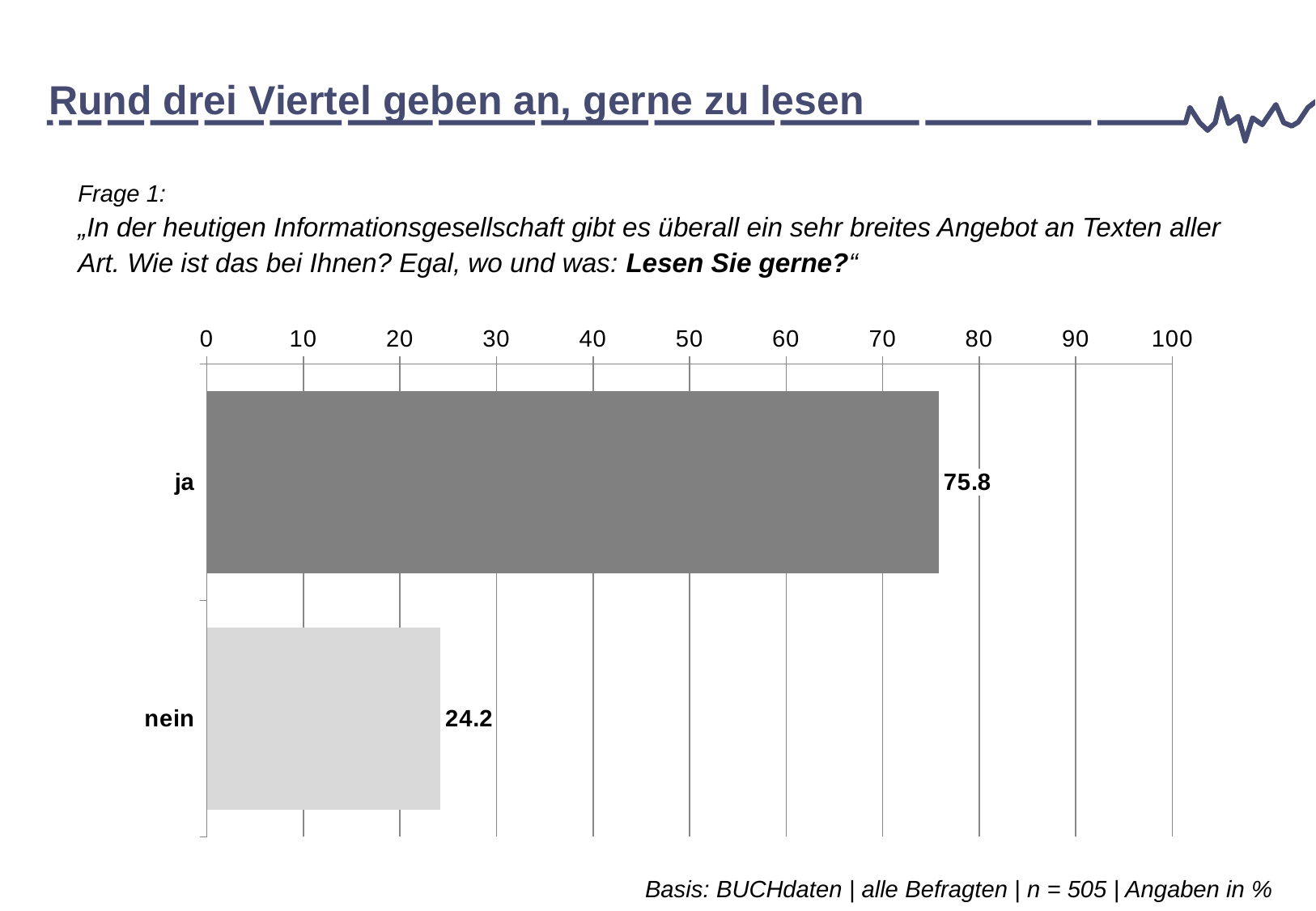
What is the value for "ja"? 75.8 What is the value for "nein"? 24.2 What is the maximum value shown on the horizontal axis? 100 Which category has the highest value? ja What is the difference between the values for "ja" and "nein"? 51.6 What is the sample size (n) given in the basis note below the chart? 505 What kind of chart is shown on the slide? bar chart Which category has the lowest value? nein Is the value for "nein" greater or less than 30? less How many categories are shown in the chart? 2 Is the value for "ja" greater or less than 70? greater Which is larger, the value for "ja" or the value for "nein"? ja